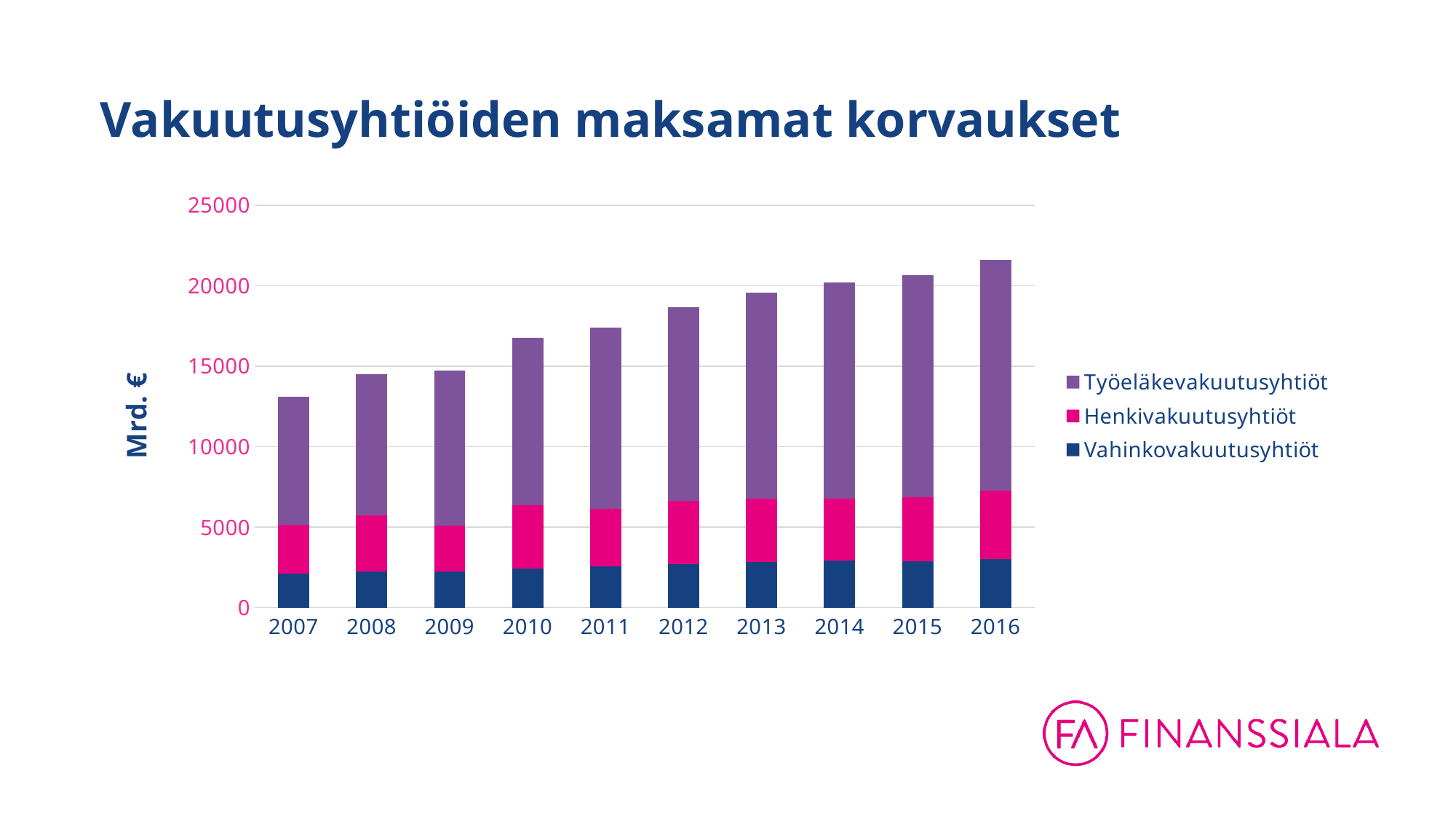
Is the total bar for 2016 greater or less than 20000? greater Do the total bar heights rise or fall from 2007 to 2016? Rise What is the label on the y axis of the chart? Mrd. € How many series does the chart's legend list? 3 How many years are shown on the x axis of the chart? 10 Which year has the lowest total bar in the chart? 2007 Is the total bar for 2007 greater or less than 15000? less What kind of chart is shown on the slide? Stacked bar chart Which year has the highest total bar in the chart? 2016 What is the title of the chart? Vakuutusyhtiöiden maksamat korvaukset Is the total bar for 2016 larger or smaller than the total bar for 2007? Larger Is the total bar for 2010 greater or less than 15000? greater